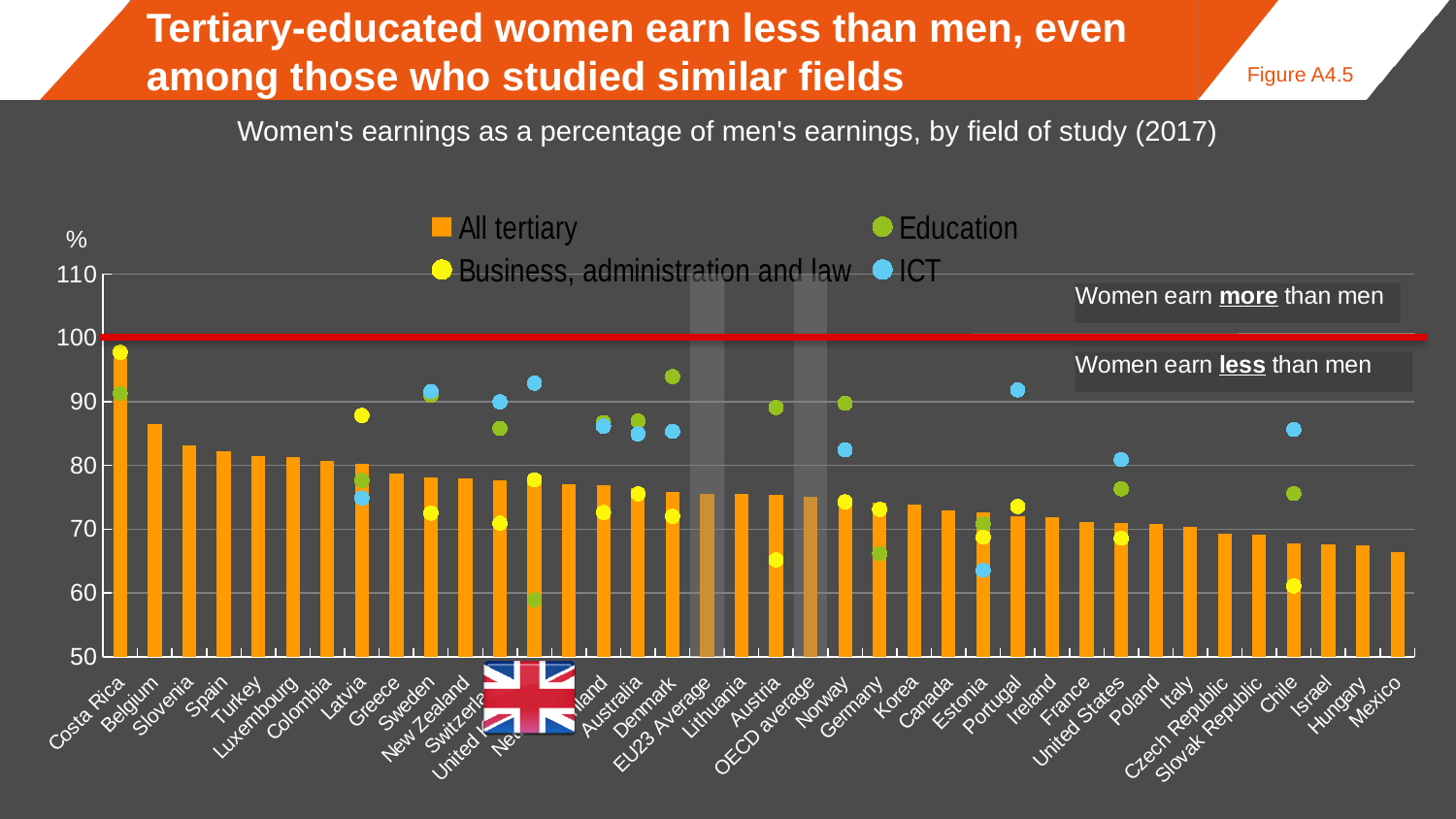
At what value is the red horizontal line drawn on the chart? 100 Is the Education value for Denmark greater or less than 90? greater Is the ICT value for Portugal greater or less than 90? greater Which country has the highest All tertiary bar? Costa Rica Which has the larger All tertiary value, Belgium or Spain? Belgium How many series does the legend list? 4 Which country has the lowest All tertiary bar? Mexico Do the All tertiary bars rise or fall from left to right across the countries? Fall Is the All tertiary value for Mexico greater or less than 70? less What kind of chart is shown on the slide? Bar chart